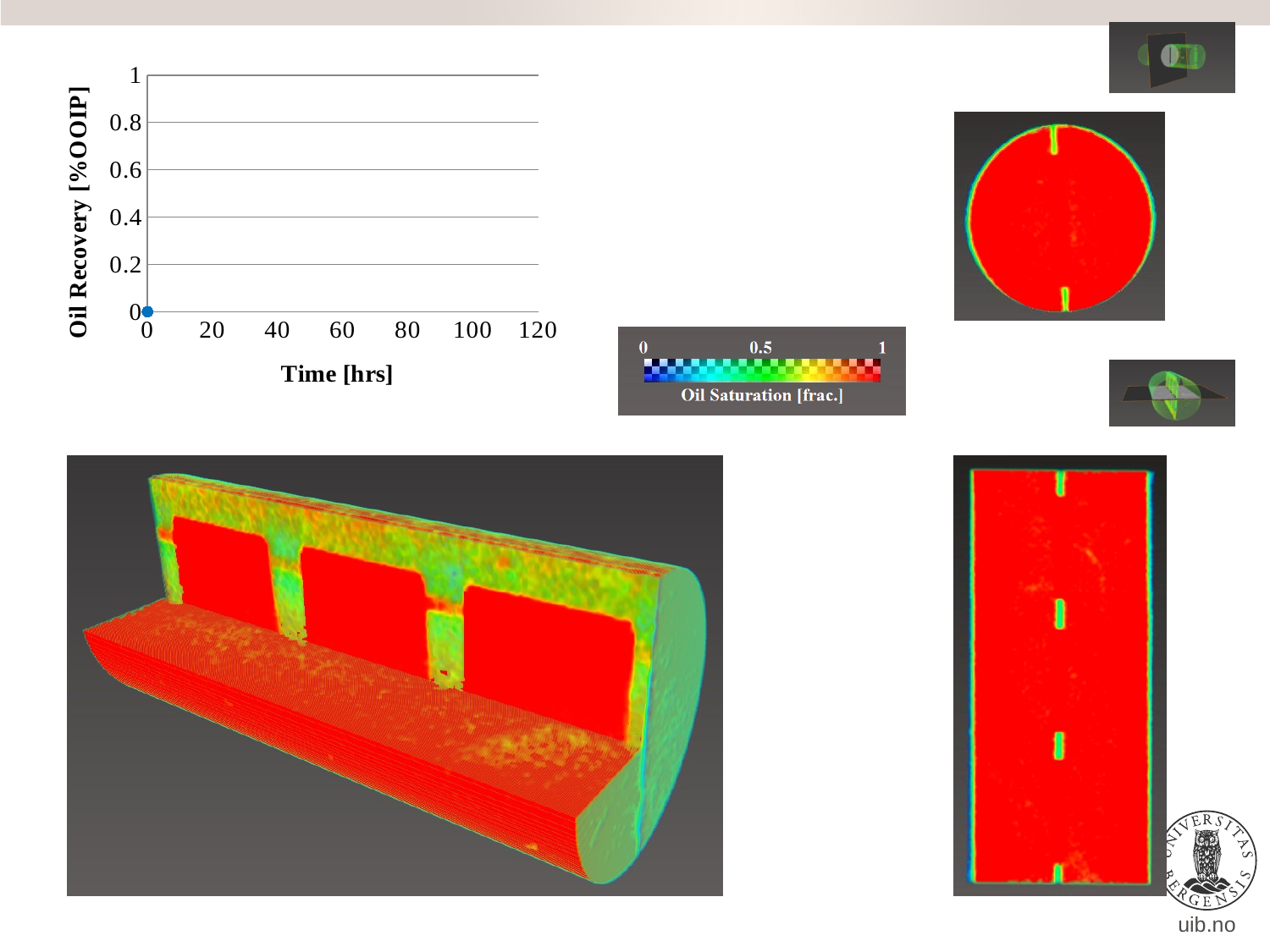
Is the plotted oil recovery value at time 0 greater or less than 0.2? less How many data points are plotted on the Oil Recovery chart? 1 What is the highest tick value shown on the y axis of the Oil Recovery chart? 1 What kind of chart is the Oil Recovery chart? scatter chart What is the highest tick value shown on the x axis of the Oil Recovery chart? 120 What is the label of the x axis on the Oil Recovery chart? Time [hrs] What is the oil recovery value plotted at time 0 hrs? 0 At what time value is the single data point on the Oil Recovery chart plotted? 0 What is the label of the y axis on the Oil Recovery chart? Oil Recovery [%OOIP]